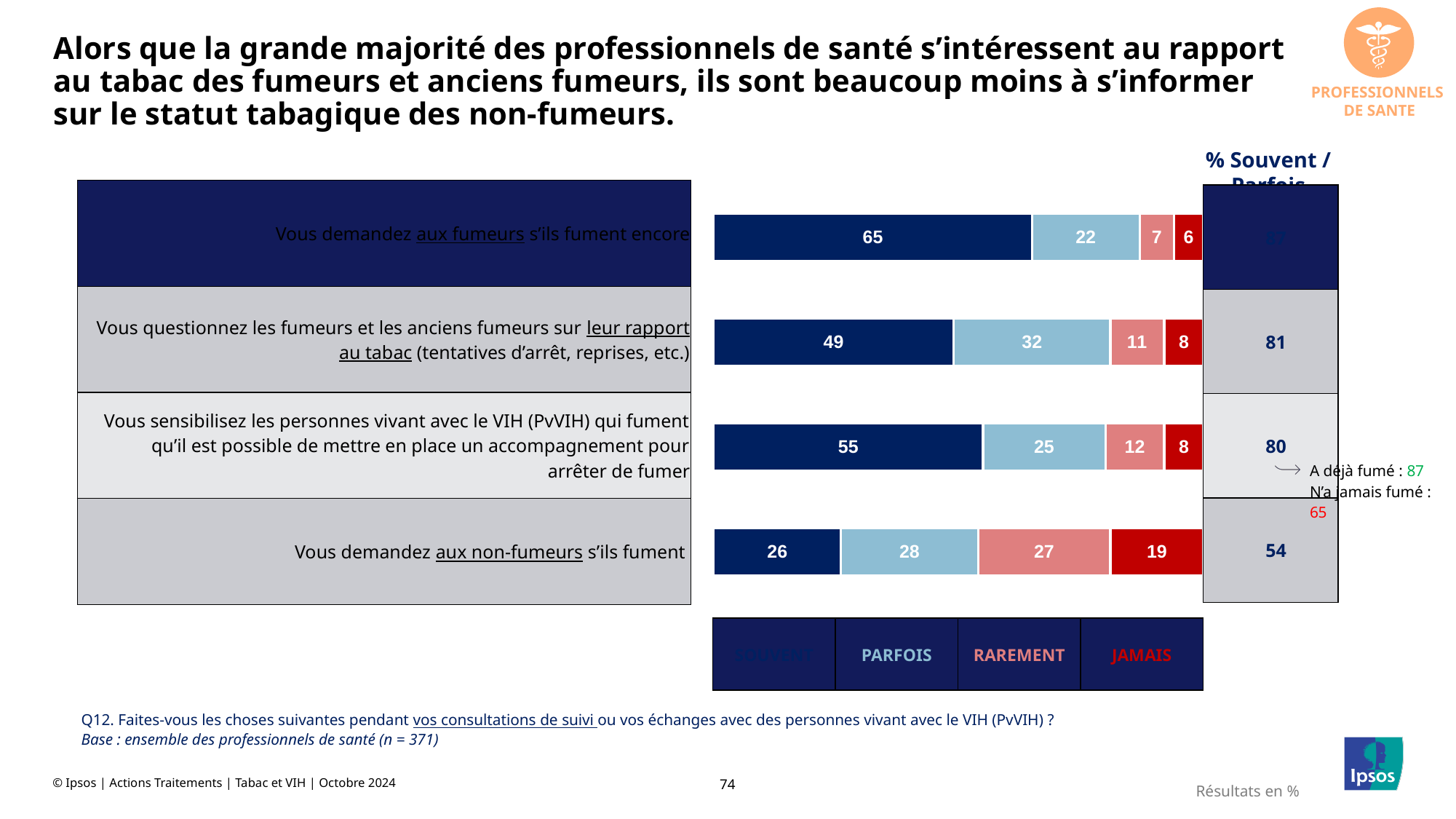
What is the '% Souvent / Parfois' value for 'Vous demandez aux non-fumeurs s'ils fument'? 54 Which is larger: the 'Parfois' value for 'Vous demandez aux non-fumeurs s'ils fument' or the 'Parfois' value for 'Vous demandez aux fumeurs s'ils fument encore'? Vous demandez aux non-fumeurs s'ils fument How many series does the legend list? 4 What is the 'Jamais' value for 'Vous demandez aux non-fumeurs s'ils fument'? 19 What kind of chart is shown on the slide? Stacked bar chart What is the 'Souvent' value for 'Vous demandez aux fumeurs s'ils fument encore'? 65 How many items (categories) are shown in the chart? 4 What is the 'Parfois' value for 'Vous questionnez les fumeurs et les anciens fumeurs sur leur rapport au tabac'? 32 Which item has the lowest 'Souvent' value? Vous demandez aux non-fumeurs s'ils fument Which item has the highest 'Souvent' value? Vous demandez aux fumeurs s'ils fument encore What is the difference between the 'Jamais' values for 'Vous demandez aux non-fumeurs s'ils fument' and 'Vous demandez aux fumeurs s'ils fument encore'? 13 What is the 'Rarement' value for 'Vous sensibilisez les personnes vivant avec le VIH (PvVIH) qui fument qu'il est possible de mettre en place un accompagnement pour arrêter de fumer'? 12